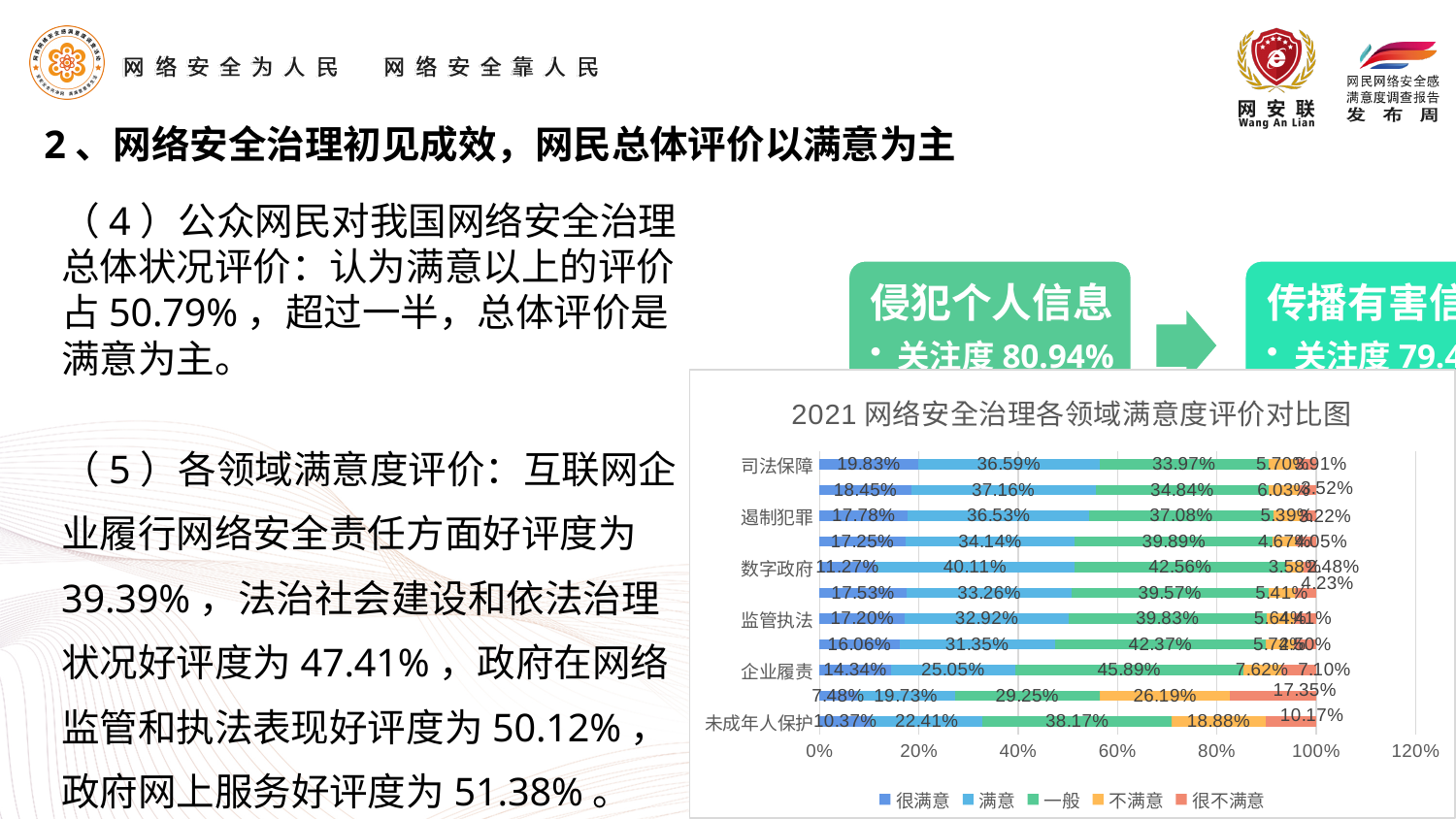
What is the 一般 value for 企业履责? 45.89% Which category has the highest 一般 value? 企业履责 Which has the larger 很满意 value: 监管执法 or 企业履责? 监管执法 What is the 满意 value for 数字政府? 40.11% What is the 不满意 value for 未成年人保护? 18.88% How many series does the legend of the chart list? 5 What is the title of the chart? 2021 网络安全治理各领域满意度评价对比图 Which category has the highest 很满意 value? 司法保障 What is the 很满意 value for 司法保障? 19.83% For 数字政府, which is larger: the 满意 value or the 一般 value? 一般 What type of chart is shown on the slide? bar chart For 司法保障, what is the difference between the 满意 value and the 很满意 value? 16.76%